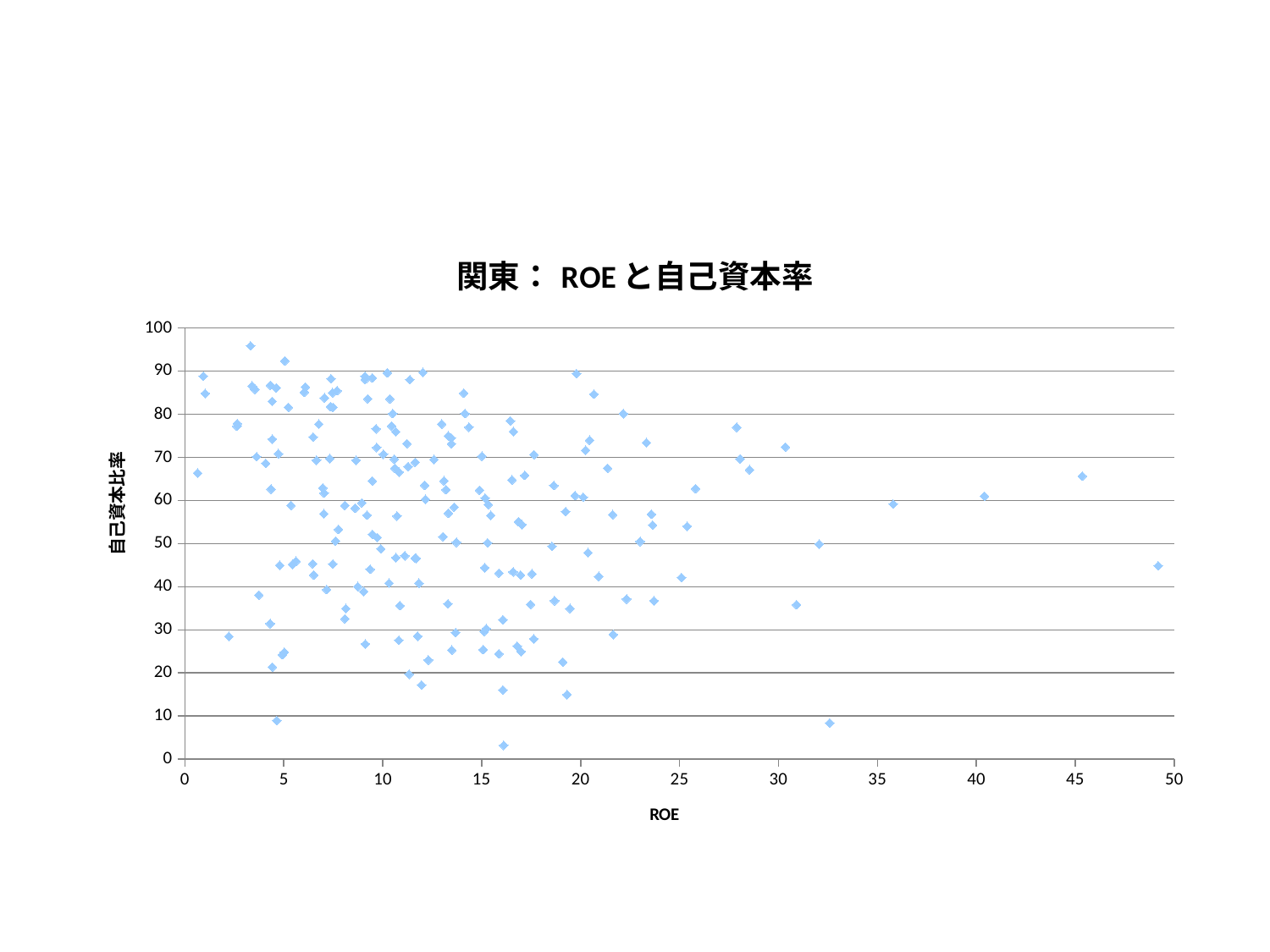
What kind of chart is shown on the slide? Scatter plot Is the ROE of the rightmost point greater or less than 45? greater Is the 自己資本比率 of the rightmost point (ROE near 49) greater or less than 50? less What is the label of the horizontal axis? ROE What is the interval between tick marks on the vertical axis? 10 What is the title of the chart? 関東： ROE と自己資本率 Is the 自己資本比率 of the highest point greater or less than 90? greater What is the maximum value shown on the horizontal (ROE) axis? 50 What is the maximum value shown on the vertical axis? 100